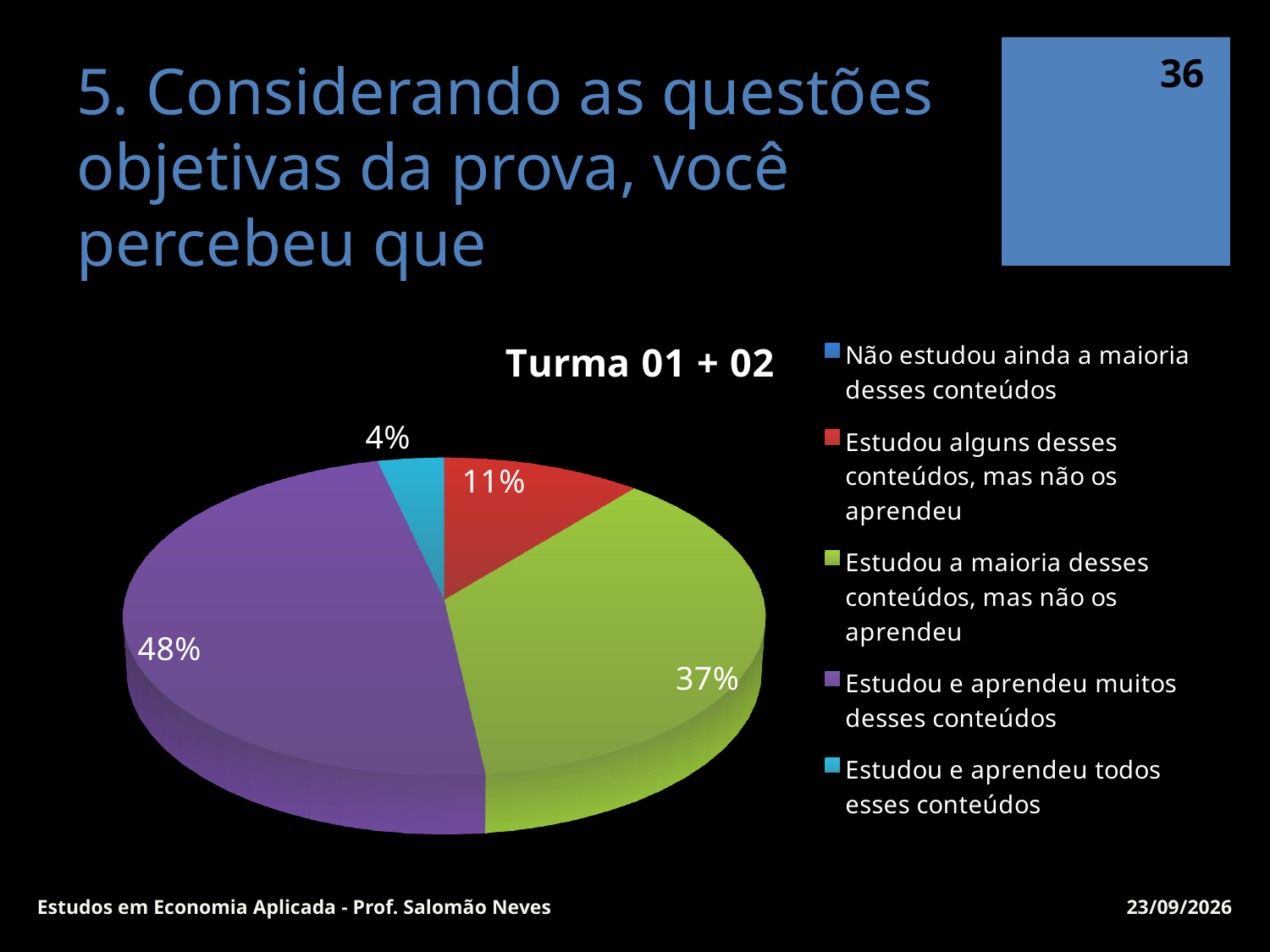
Which labelled slice of the pie is the smallest? Estudou e aprendeu todos esses conteúdos What is the title of the chart? Turma 01 + 02 Which is larger: the share for "Estudou alguns desses conteúdos, mas não os aprendeu" or for "Estudou e aprendeu todos esses conteúdos"? Estudou alguns desses conteúdos, mas não os aprendeu What kind of chart is shown on the slide? pie chart What share of the pie is "Estudou e aprendeu muitos desses conteúdos"? 48% What share of the pie is "Estudou a maioria desses conteúdos, mas não os aprendeu"? 37% What is the difference in percentage points between the 48% slice and the 37% slice? 11 What colour is the slice for "Estudou a maioria desses conteúdos, mas não os aprendeu"? green What share of the pie is "Estudou e aprendeu todos esses conteúdos"? 4% What share of the pie is "Estudou alguns desses conteúdos, mas não os aprendeu"? 11% Which category has the largest slice of the pie? Estudou e aprendeu muitos desses conteúdos How many entries does the legend list? 5